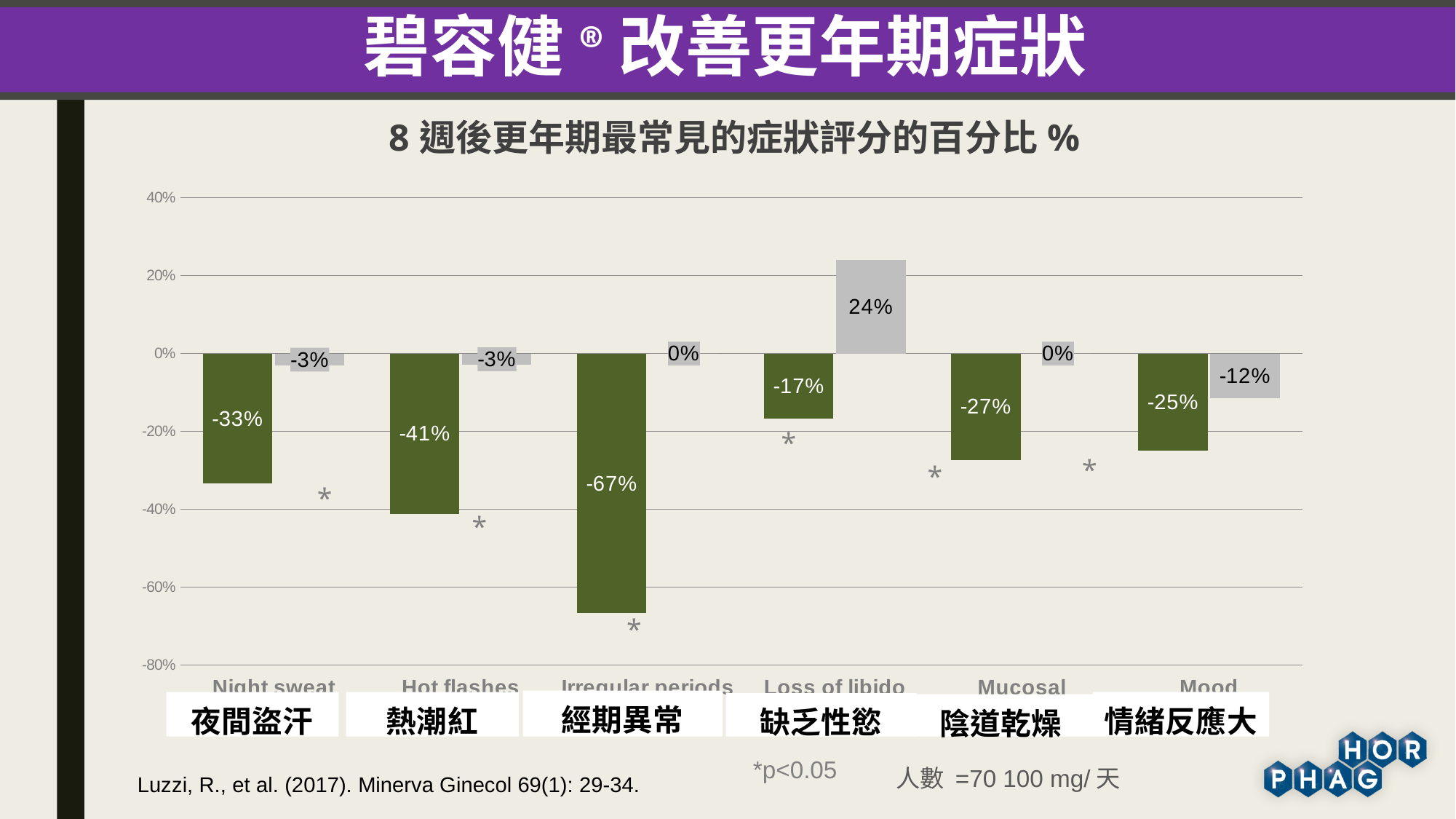
What is the value of the grey bar for 缺乏性慾 (Loss of libido)? 24% What is the difference between the green bar values for 經期異常 (Irregular periods) and 夜間盜汗 (Night sweat)? 34 percentage points What is the value of the grey bar for 夜間盜汗 (Night sweat)? -3% What is the value of the green bar for 情緒反應大 (Mood)? -25% How many categories are shown on the x axis? 6 What kind of chart is shown on the slide? Bar chart Which category has the lowest (most negative) green bar value? 經期異常 (Irregular periods) Which category has the highest grey bar value? 缺乏性慾 (Loss of libido) What is the value of the green bar for 熱潮紅 (Hot flashes)? -41% How many categories have a grey bar value of 0%? 2 Which is more negative: the green bar for 陰道乾燥 (Mucosal) or the green bar for 缺乏性慾 (Loss of libido)? 陰道乾燥 (Mucosal) What is the title of the chart? 8 週後更年期最常見的症狀評分的百分比 %